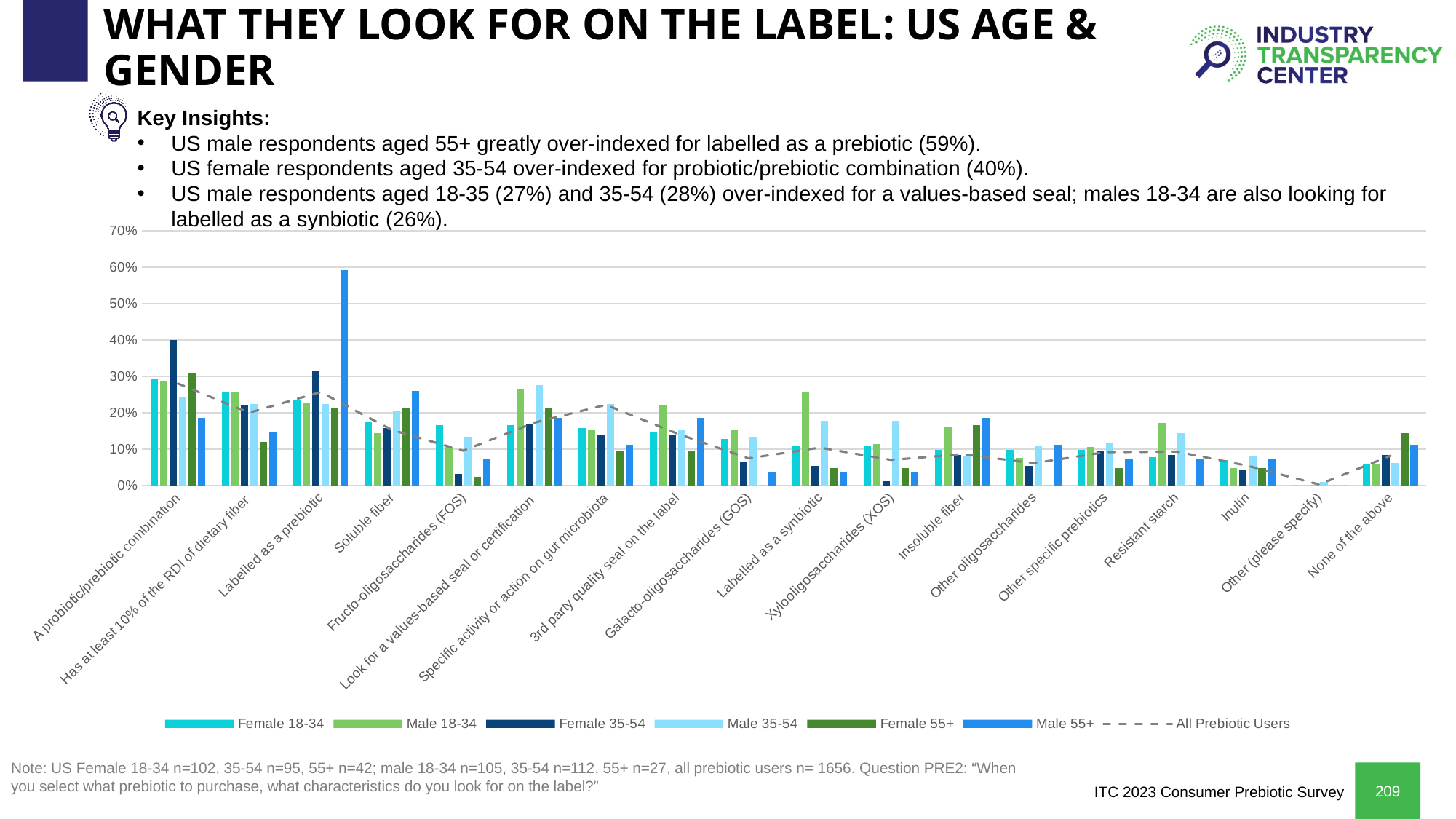
For Female 35-54 respondents, which is larger: 'A probiotic/prebiotic combination' or 'Labelled as a prebiotic'? A probiotic/prebiotic combination What kind of chart is shown on the slide? Combination bar and line chart Which series in the legend is drawn as a dashed line rather than bars? All Prebiotic Users What is the difference between Male 35-54 (28%) and Male 18-34 (27%) for 'Look for a values-based seal or certification'? 1 percentage point How many series does the chart legend list? 7 Which category has the tallest bar in the chart? Labelled as a prebiotic Is the value for Female 35-54 for 'Fructo-oligosaccharides (FOS)' greater or less than 10%? less How many label characteristics (categories) are shown along the x axis of the chart? 18 What is the value for Male 55+ respondents for 'Labelled as a prebiotic'? 59% What is the value for Male 18-34 respondents for 'Labelled as a synbiotic'? 26% Is the value for Male 55+ for 'Labelled as a prebiotic' greater or less than 50%? greater What is the value for Female 35-54 respondents for 'A probiotic/prebiotic combination'? 40%